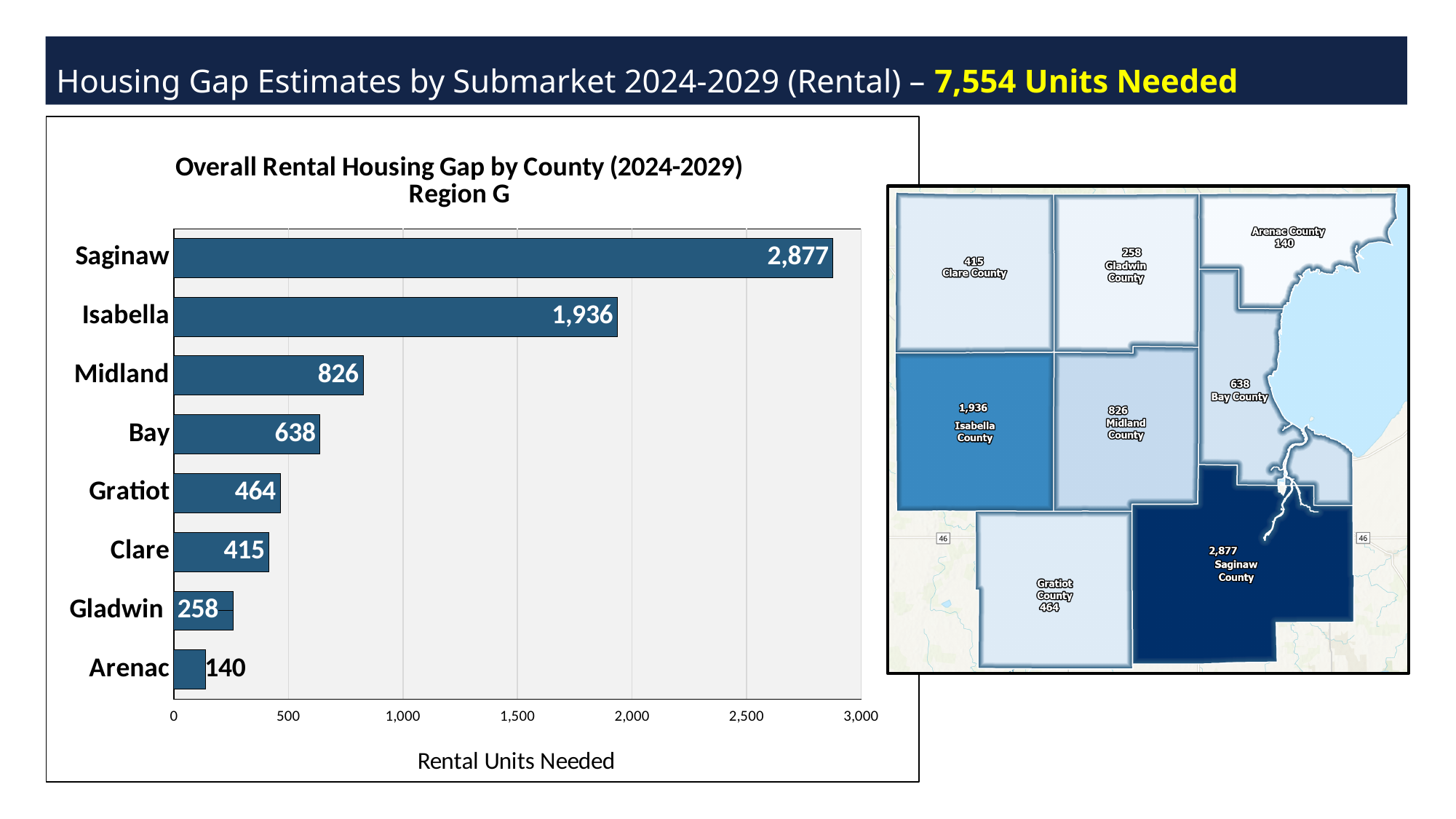
What is the difference between the values for Saginaw and Isabella? 941 What is the rental housing gap value for Saginaw? 2,877 Which county has the highest rental housing gap? Saginaw What is the x-axis label of the bar chart? Rental Units Needed How many counties are shown in the bar chart? 8 Which has a larger rental housing gap, Clare or Gladwin? Clare What kind of chart is used to show the rental housing gap by county? bar chart Is the value for Isabella greater or less than 2,000? less What is the rental housing gap value for Midland? 826 What is the difference between the values for Bay and Gratiot? 174 What is the rental housing gap value for Gladwin? 258 Which county has the lowest rental housing gap? Arenac